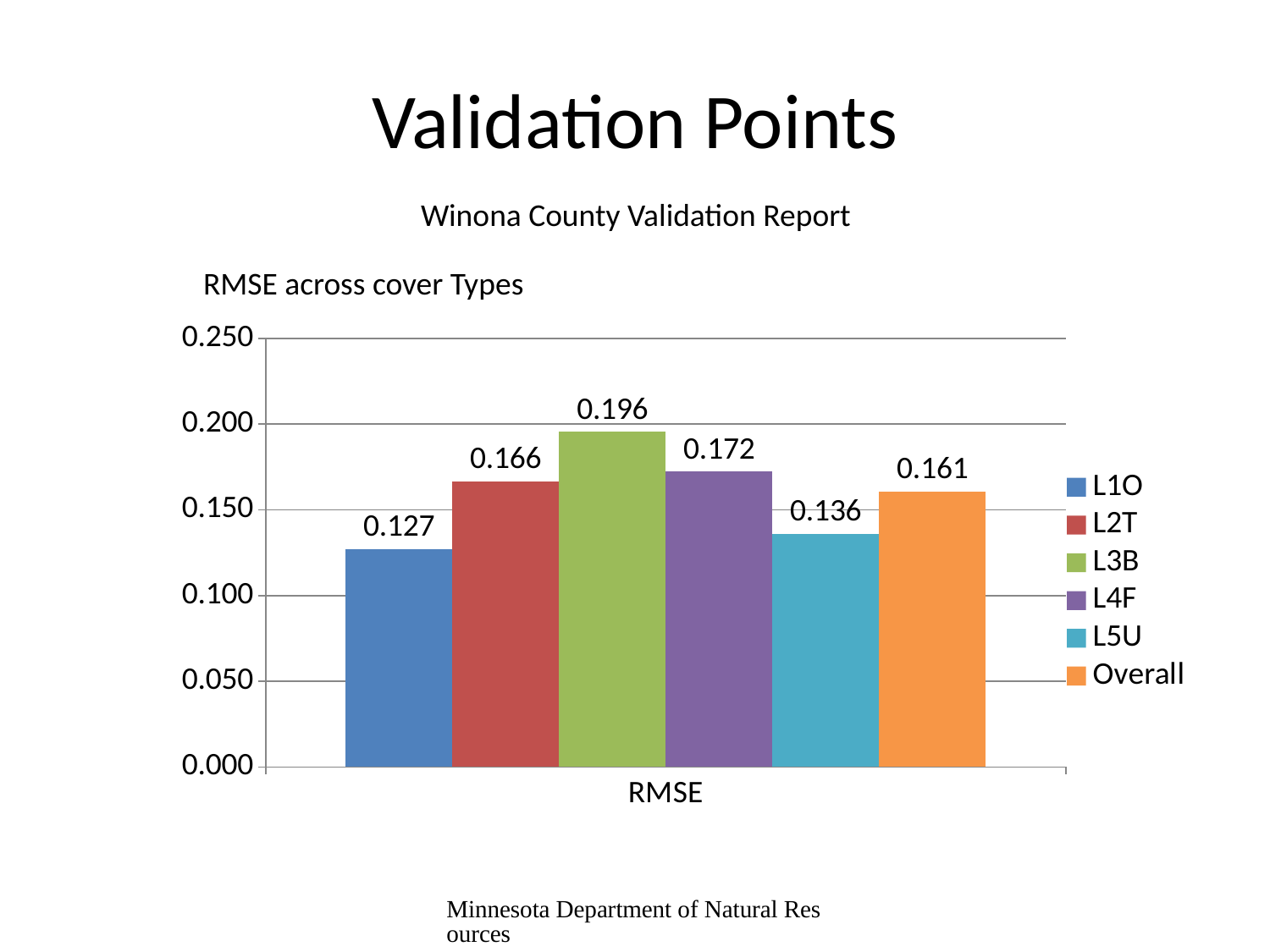
Which series has the highest RMSE? L3B Which has a larger RMSE, L2T or L5U? L2T What is the difference between the RMSE for L4F and the RMSE for L2T? 0.006 How many series does the legend list? 6 What is the title of the chart? RMSE across cover Types What is the RMSE value for L1O? 0.127 What is the RMSE value for L3B? 0.196 Which series has the lowest RMSE? L1O Is the RMSE for L5U greater or less than 0.150? less What kind of chart is shown on the slide? bar chart What is the Overall RMSE value shown on the chart? 0.161 What is the difference between the RMSE for L3B and the RMSE for L1O? 0.069